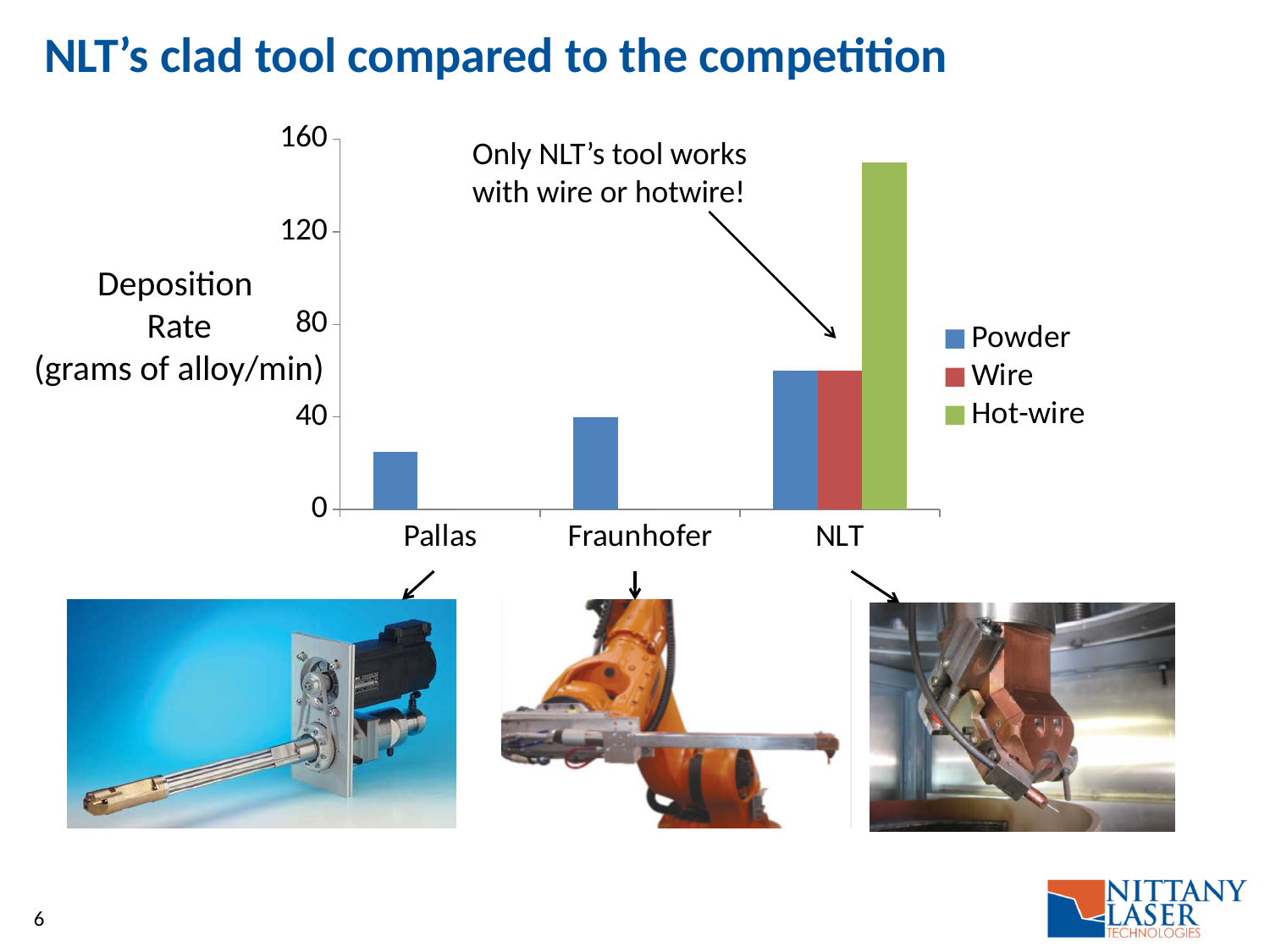
How many series does the legend list? 3 Is the Hot-wire value for NLT greater or less than 120? greater Is the Powder value for NLT greater or less than 80? less Which category has the highest Powder deposition rate? NLT How many categories are shown on the x axis? 3 Which is larger for NLT, the Hot-wire value or the Wire value? Hot-wire Which is larger, the Powder value for Fraunhofer or the Powder value for Pallas? Fraunhofer Is the Powder value for Pallas greater or less than 40? less What is the label on the y axis of the chart? Deposition Rate (grams of alloy/min) Which category is the only one with bars for all three series? NLT What kind of chart is shown on the slide? bar chart Which category has the lowest Powder deposition rate? Pallas